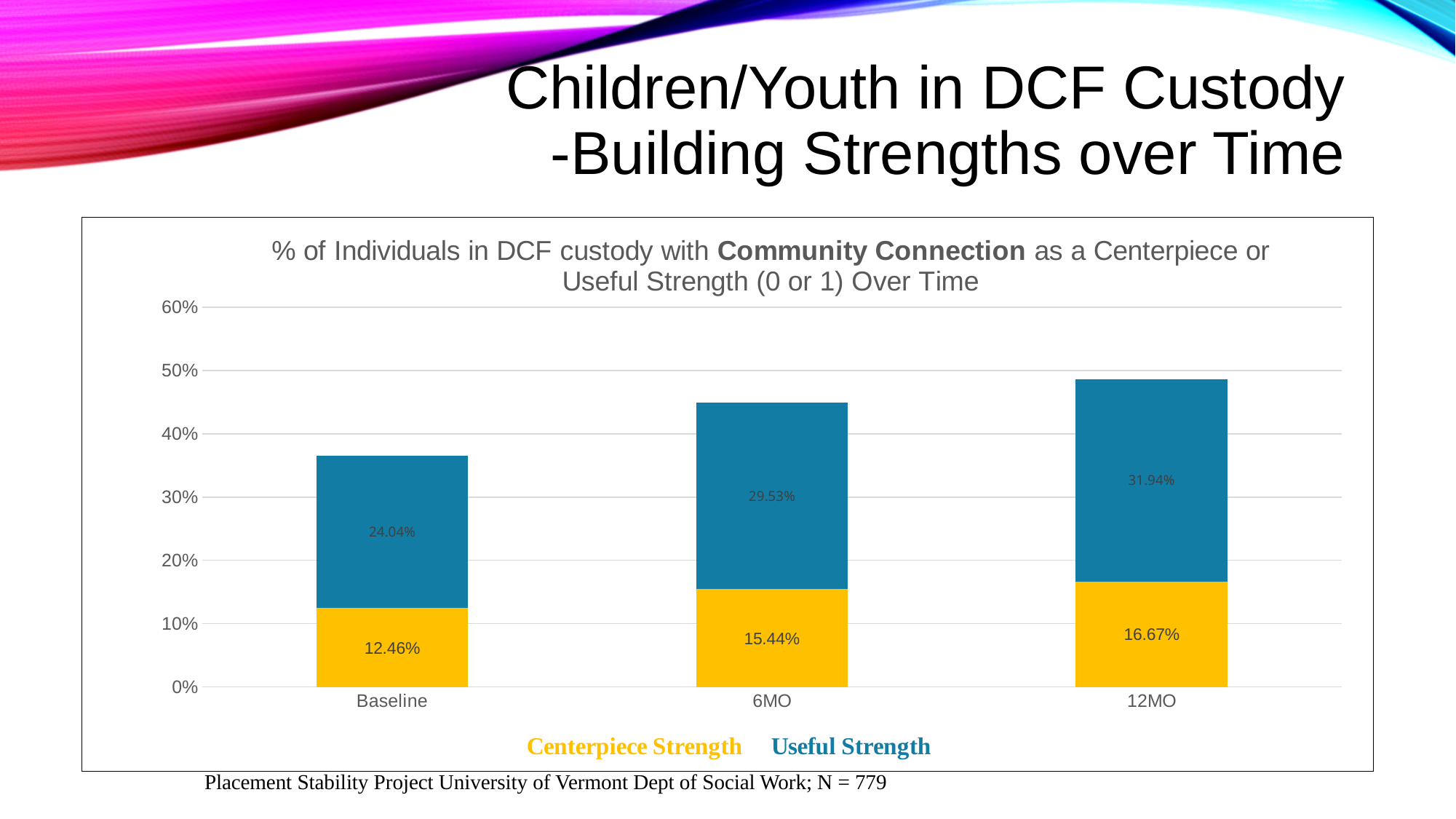
What is the difference between the Useful Strength values at 12MO and Baseline? 7.90% What kind of chart is shown on the slide? Stacked bar chart Which time point has the highest Centerpiece Strength value? 12MO What is the Useful Strength value for 12MO? 31.94% Which time point has the lowest Useful Strength value? Baseline What is the Useful Strength value for 6MO? 29.53% Which is larger: the Centerpiece Strength value at 6MO or at Baseline? 6MO What is the Centerpiece Strength value for Baseline? 12.46% How many time points are shown on the x axis? 3 What is the total of the stacked bar for 6MO? 44.97% How many series does the legend list? 2 Is the total height of the 12MO stacked bar greater or less than 40%? greater